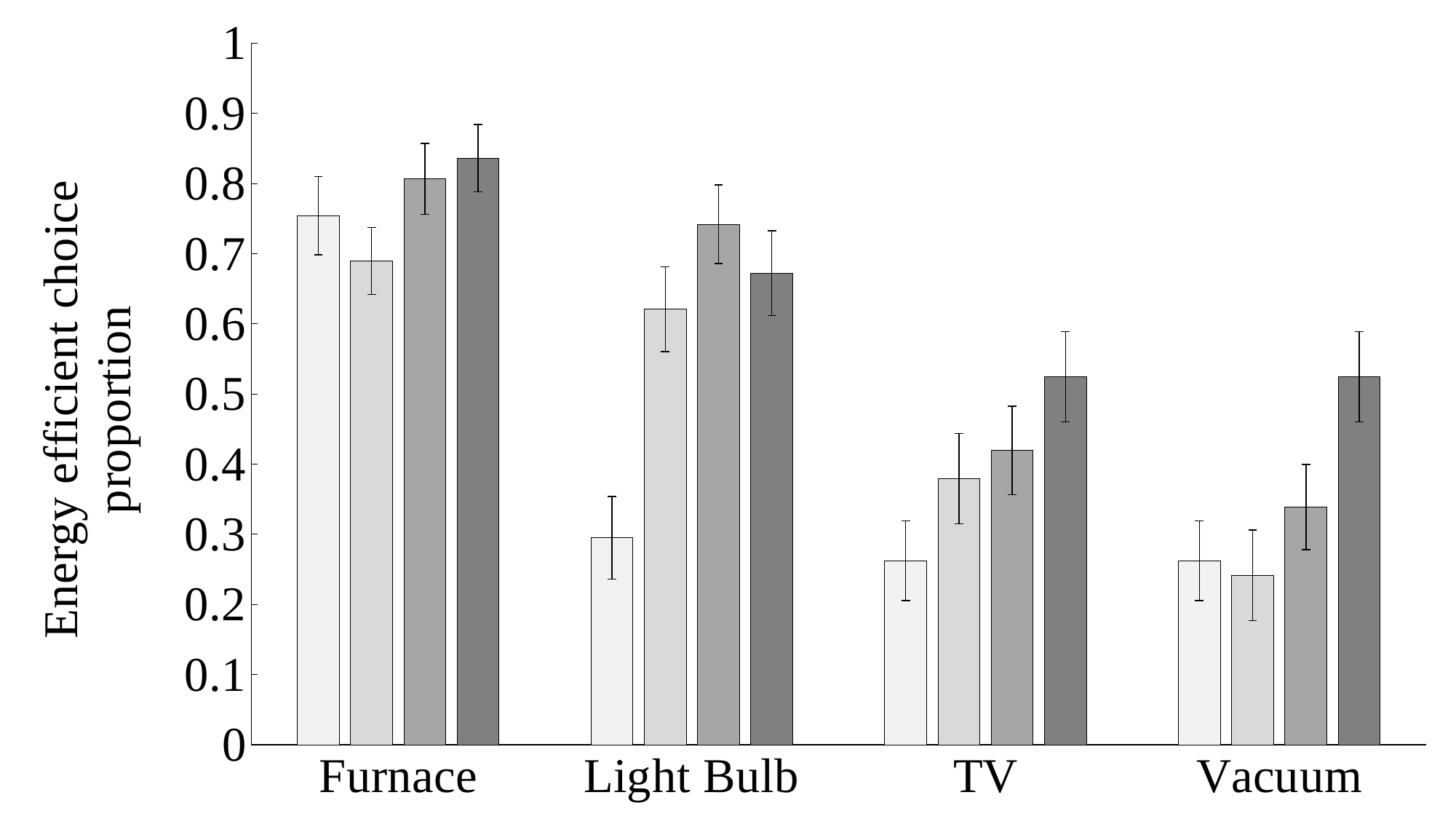
Which category has the tallest darkest bar? Furnace Within the TV group, do the bars rise or fall from left to right? rise What is the title of the y axis? Energy efficient choice proportion Within the Light Bulb group, which bar is the lowest? the lightest bar Is the value of the lightest bar for Light Bulb greater or less than 0.4? less Is the value of the darkest bar for TV greater or less than 0.6? less Is the value of the darkest bar for Furnace greater or less than 0.8? greater How many categories are shown on the x axis? 4 What kind of chart is shown on the slide? bar chart Which is larger: the lightest bar for Furnace or the lightest bar for Vacuum? Furnace How many bars are plotted for each category? 4